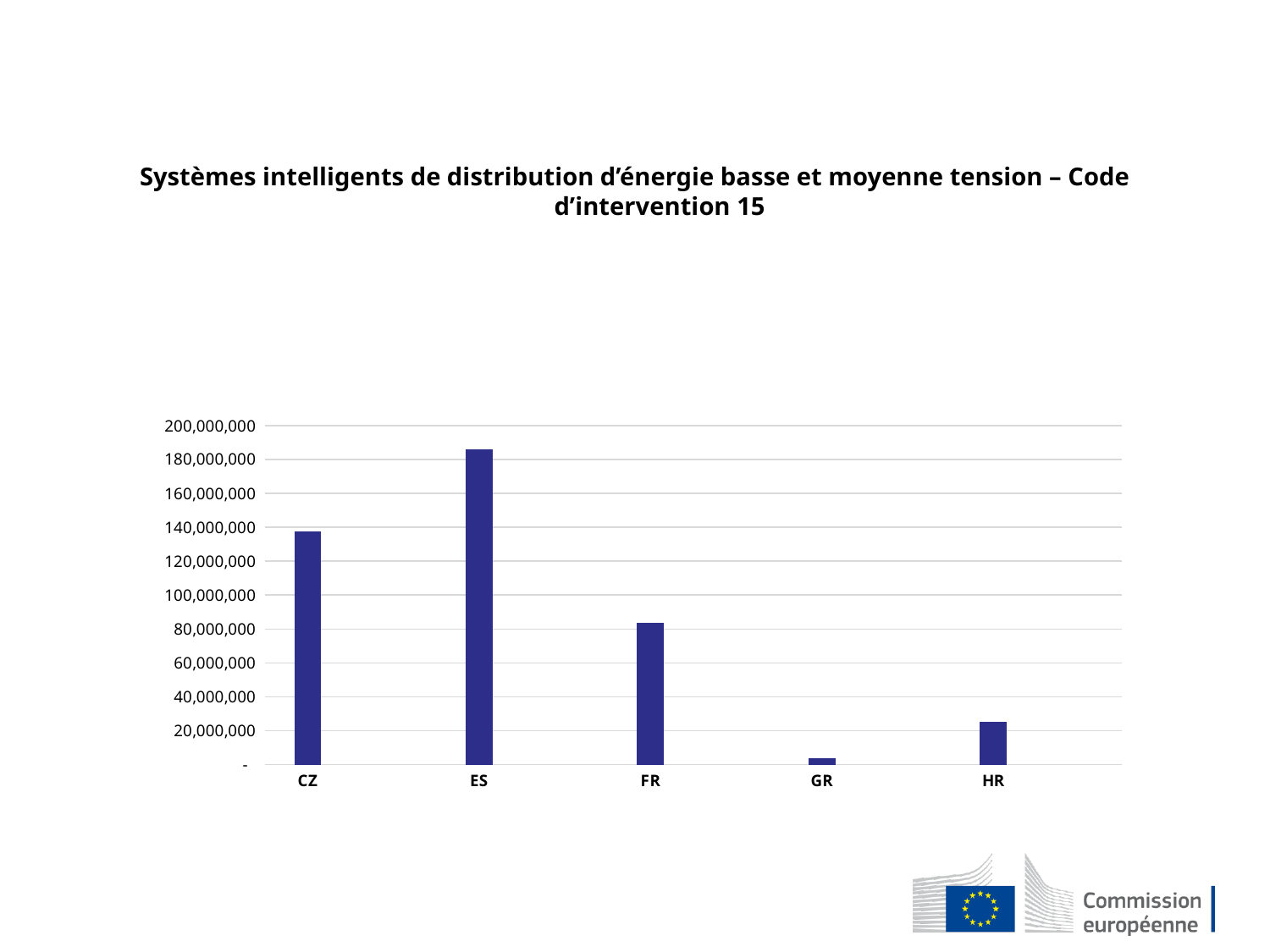
What kind of chart is shown on the slide? bar chart Which country has the lowest value in the chart? GR What is the title of the chart on the slide? Systèmes intelligents de distribution d'énergie basse et moyenne tension – Code d'intervention 15 Which has a larger value, CZ or FR? CZ How many countries are shown on the x axis of the chart? 5 Is the value for FR greater or less than 100,000,000? less Is the value for HR greater or less than 40,000,000? less Which has a larger value, HR or GR? HR Is the value for ES greater or less than 160,000,000? greater Which country has the highest value in the chart? ES Which has a larger value, ES or CZ? ES